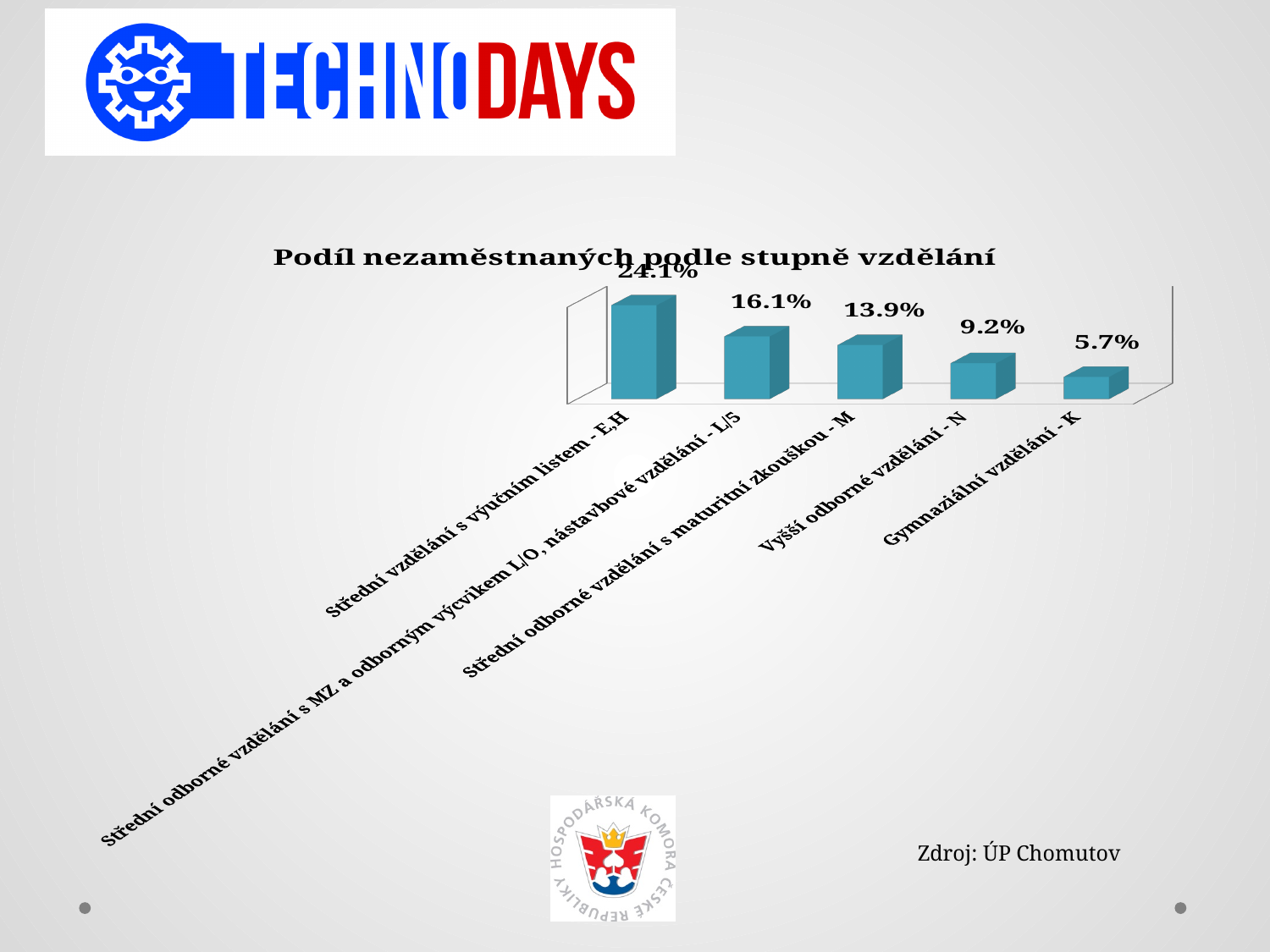
Which is larger, the value for Vyšší odborné vzdělání - N or the value for Gymnaziální vzdělání - K? Vyšší odborné vzdělání - N What is the value for Vyšší odborné vzdělání - N? 9.2% How many categories are shown in the chart? 5 What is the title of the chart? Podíl nezaměstnaných podle stupně vzdělání What is the value for Gymnaziální vzdělání - K? 5.7% Which category has the lowest value? Gymnaziální vzdělání - K What is the difference between the values for Střední vzdělání s výučním listem - E,H and Gymnaziální vzdělání - K? 18.4% What kind of chart is shown on the slide? Bar chart What is the value for Střední vzdělání s výučním listem - E,H? 24.1% What is the difference between the values for Střední odborné vzdělání s maturitní zkouškou - M and Vyšší odborné vzdělání - N? 4.7% What is the value for Střední odborné vzdělání s maturitní zkouškou - M? 13.9% Which category has the highest value? Střední vzdělání s výučním listem - E,H